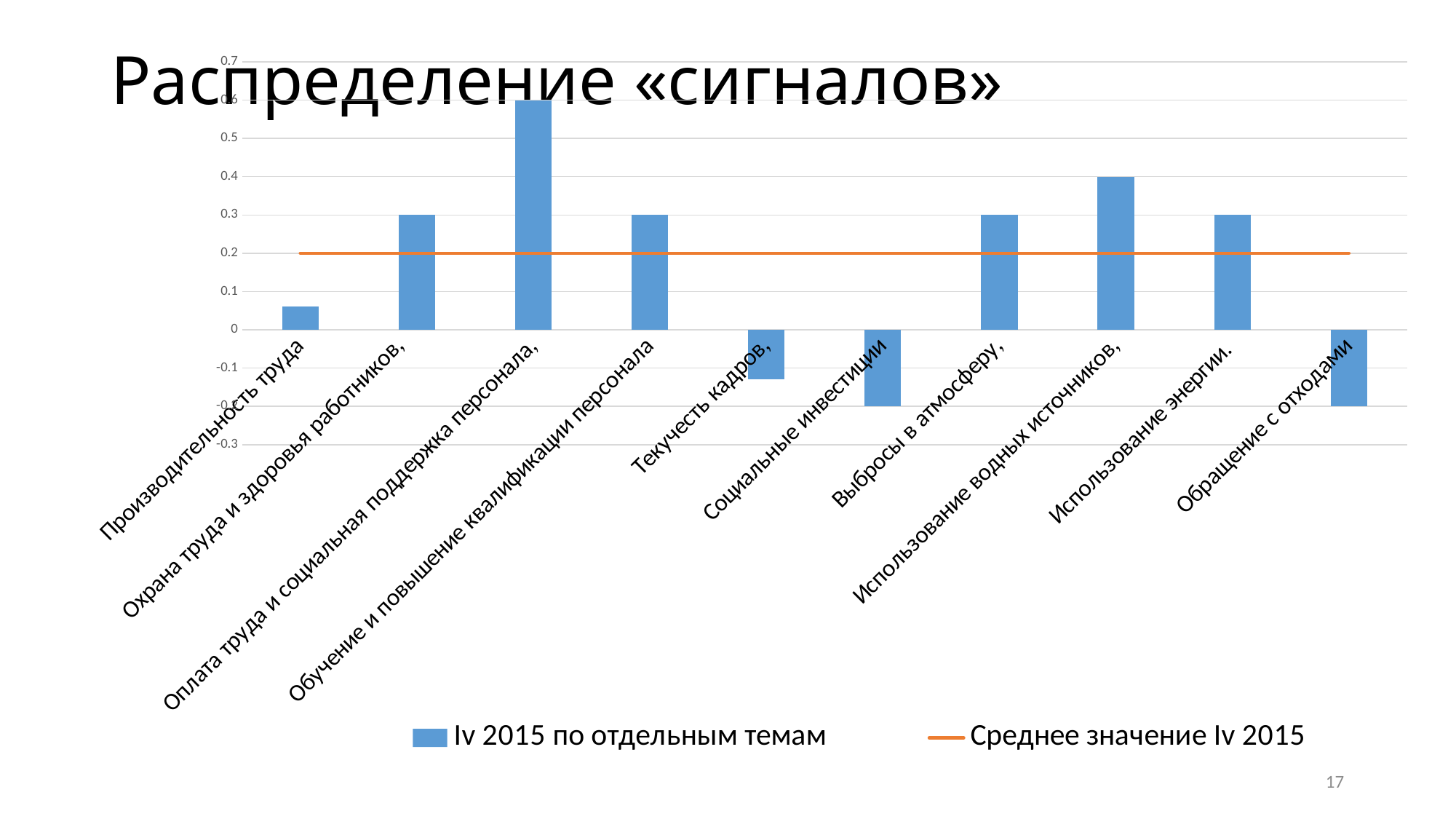
Is the value for Производительность труда greater or less than 0.1? less What is the difference between the value for Оплата труда и социальная поддержка персонала and the value for Использование водных источников? 0.2 Which category has the highest value for Iv 2015 по отдельным темам? Оплата труда и социальная поддержка персонала Which is larger: the value for Использование водных источников or the value for Выбросы в атмосферу? Использование водных источников Is the value for Текучесть кадров greater or less than 0? less What is the legend label of the orange line? Среднее значение Iv 2015 How many series does the legend list? 2 What is the value for Охрана труда и здоровья работников? 0.3 How many categories are plotted along the x axis? 10 What kind of chart is shown on the slide? combination bar and line chart What is the value for Использование водных источников? 0.4 What is the value of the Среднее значение Iv 2015 line? 0.2